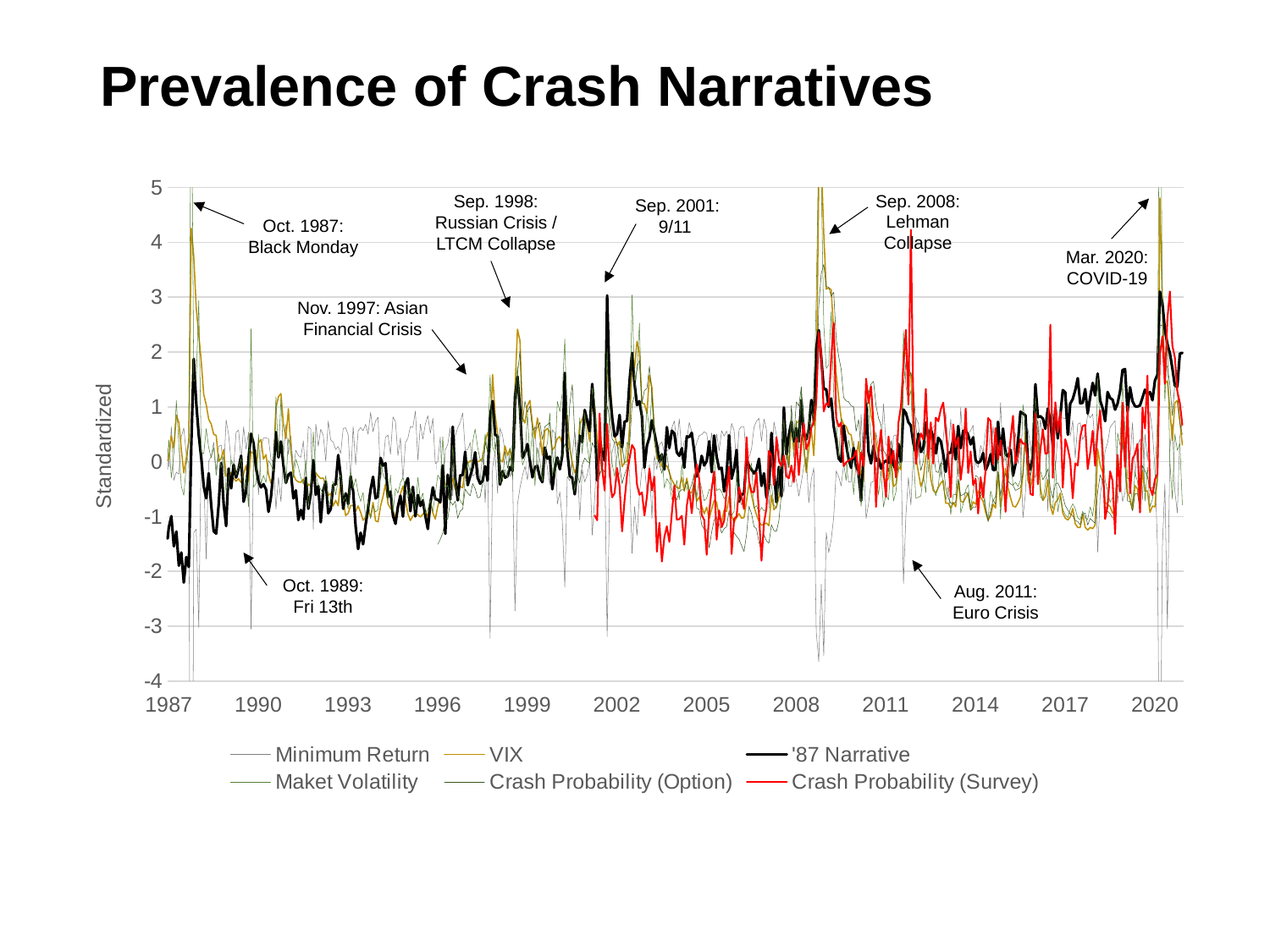
What kind of chart is shown on the slide? line chart What is the first year shown on the horizontal axis? 1987 What is the highest value shown on the vertical axis? 5 Is the value of the '87 Narrative series at its Mar. 2020 (COVID-19) peak greater or less than 2? greater What is the label on the vertical axis? Standardized Is the value of the '87 Narrative series at its Sep. 2001 (9/11) peak greater or less than 2? greater What is the title of the chart? Prevalence of Crash Narratives Is the value of the '87 Narrative series at its Sep. 2008 (Lehman Collapse) peak greater or less than 1? greater How many series does the legend list? 6 What is the lowest value shown on the vertical axis? -4